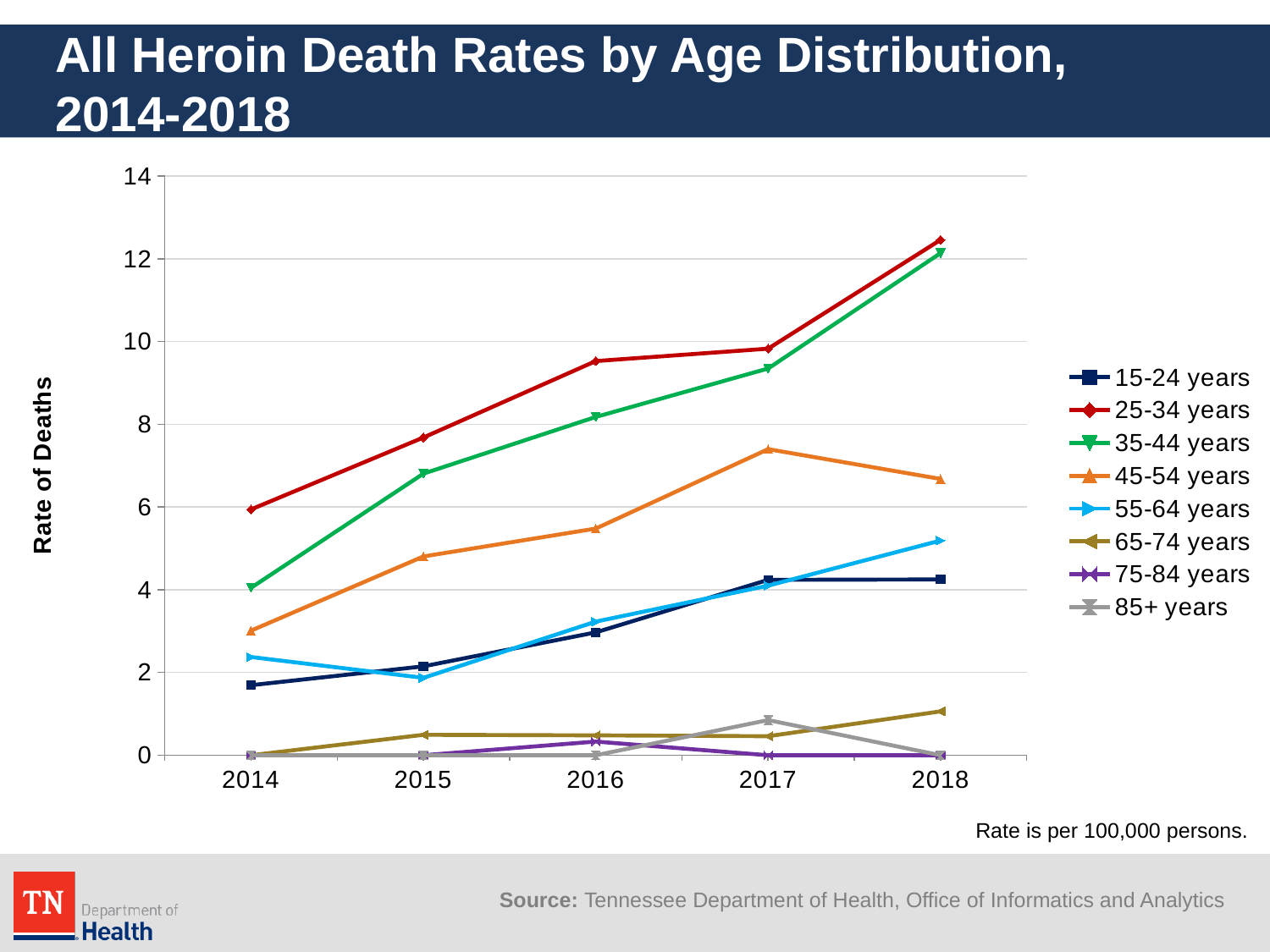
Is the value for 15-24 years in 2014 greater or less than 2? less What is the label on the y axis? Rate of Deaths Which age group has the highest heroin death rate in 2016? 25-34 years Does the death rate for 45-54 years rise or fall between 2017 and 2018? fall Which age group has the lowest heroin death rate in 2017? 75-84 years Is the value for 25-34 years in 2018 greater or less than 12? greater In 2017, which is larger: the rate for 45-54 years or the rate for 55-64 years? 45-54 years How many years are plotted along the x axis? 5 How many series does the legend list? 8 What kind of chart is shown on the slide? line chart Is the value for 35-44 years in 2015 greater or less than 6? greater Does the death rate for 25-34 years rise or fall from 2014 to 2018? rise